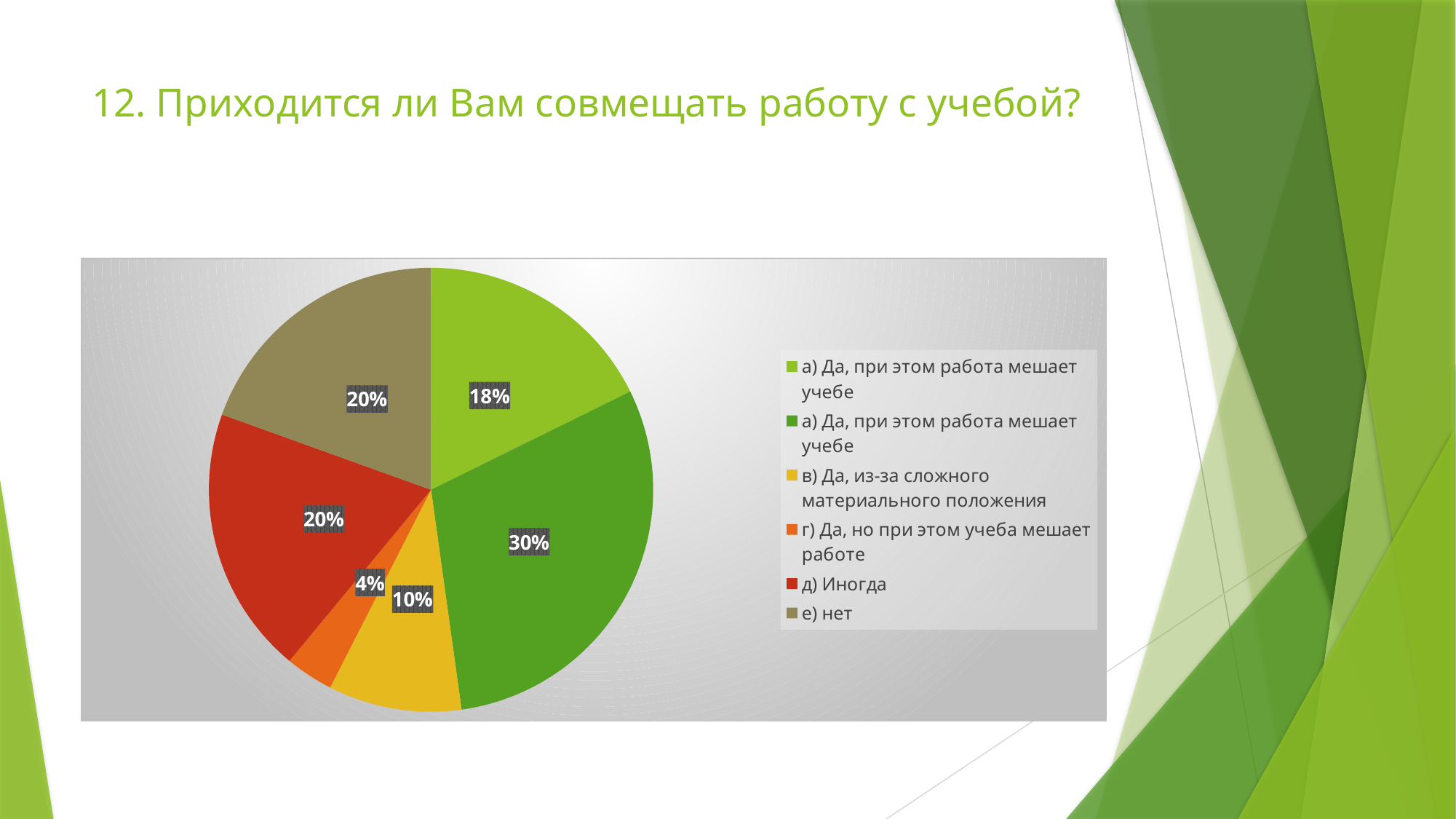
Which category has the smallest slice of the pie? г) Да, но при этом учеба мешает работе What share of the pie does the slice for "в) Да, из-за сложного материального положения" represent? 10% How many slices does the pie chart have? 6 How many entries does the legend list? 6 What share of the pie does the slice for "г) Да, но при этом учеба мешает работе" represent? 4% What share of the pie does the slice for "е) нет" represent? 20% What is the difference between the share for "д) Иногда" and the share for "г) Да, но при этом учеба мешает работе"? 16% What is the title of the slide containing the pie chart? 12. Приходится ли Вам совмещать работу с учебой? What kind of chart is shown on the slide? pie chart Which is larger: the share for "в) Да, из-за сложного материального положения" or the share for "е) нет"? е) нет What is the largest share shown on the pie chart? 30%